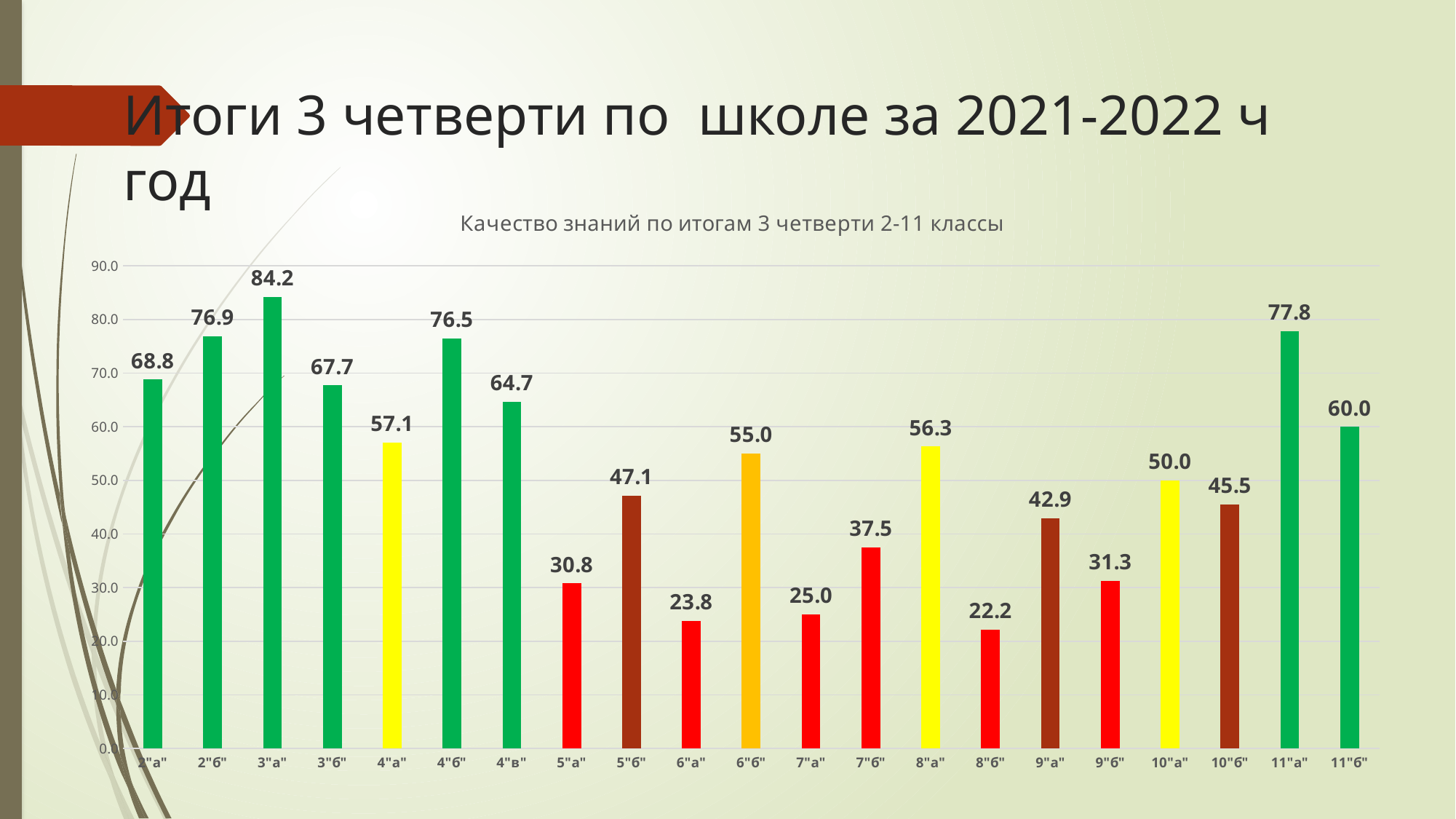
What is the value for 3"а"? 84.2 What is the title of the chart? Качество знаний по итогам 3 четверти 2-11 классы How many classes are shown on the chart? 21 What is the value for 10"а"? 50.0 What is the value for 8"б"? 22.2 What is the difference between the values for 3"а" and 8"б"? 62.0 What is the difference between the values for 11"а" and 11"б"? 17.8 Which class has the highest value? 3"а" Which has a larger value, 5"а" or 5"б"? 5"б" What is the value for 11"а"? 77.8 What kind of chart is shown on the slide? bar chart Which class has the lowest value? 8"б"